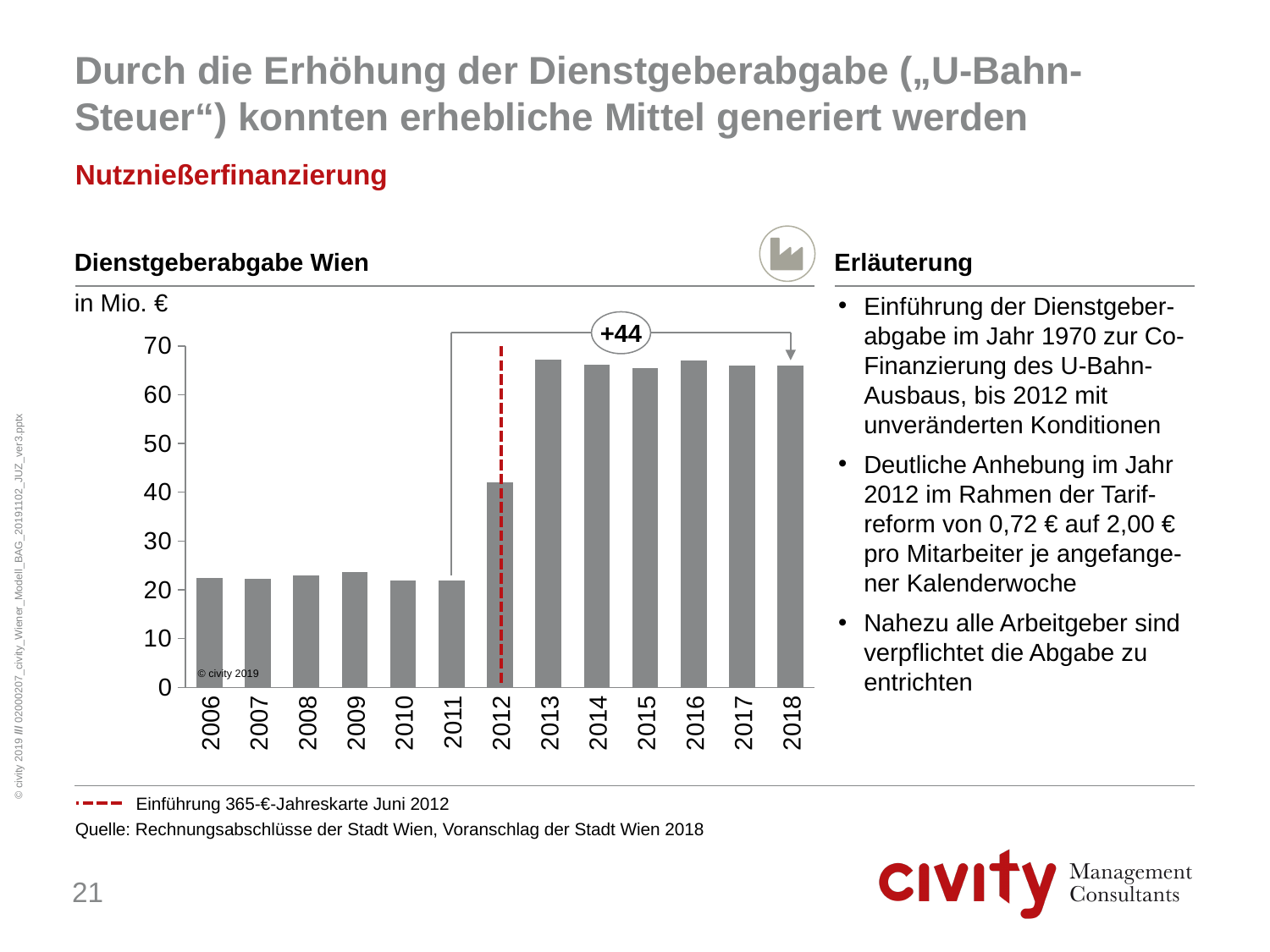
What increase in Mio. € is annotated between 2011 and 2018 on the chart? +44 What kind of chart is used to show the Dienstgeberabgabe Wien? bar chart How many years are shown on the x axis of the Dienstgeberabgabe Wien chart? 13 Is the value for 2006 greater or less than 20? greater Is the value for 2011 greater or less than 30? less Which year has the larger value, 2012 or 2013? 2013 Is the value for 2018 greater or less than 70? less What does the red dashed line in the chart mark? Einführung 365-€-Jahreskarte Juni 2012 Which year has the larger value, 2011 or 2012? 2012 Do the values rise or fall from 2011 to 2013? rise